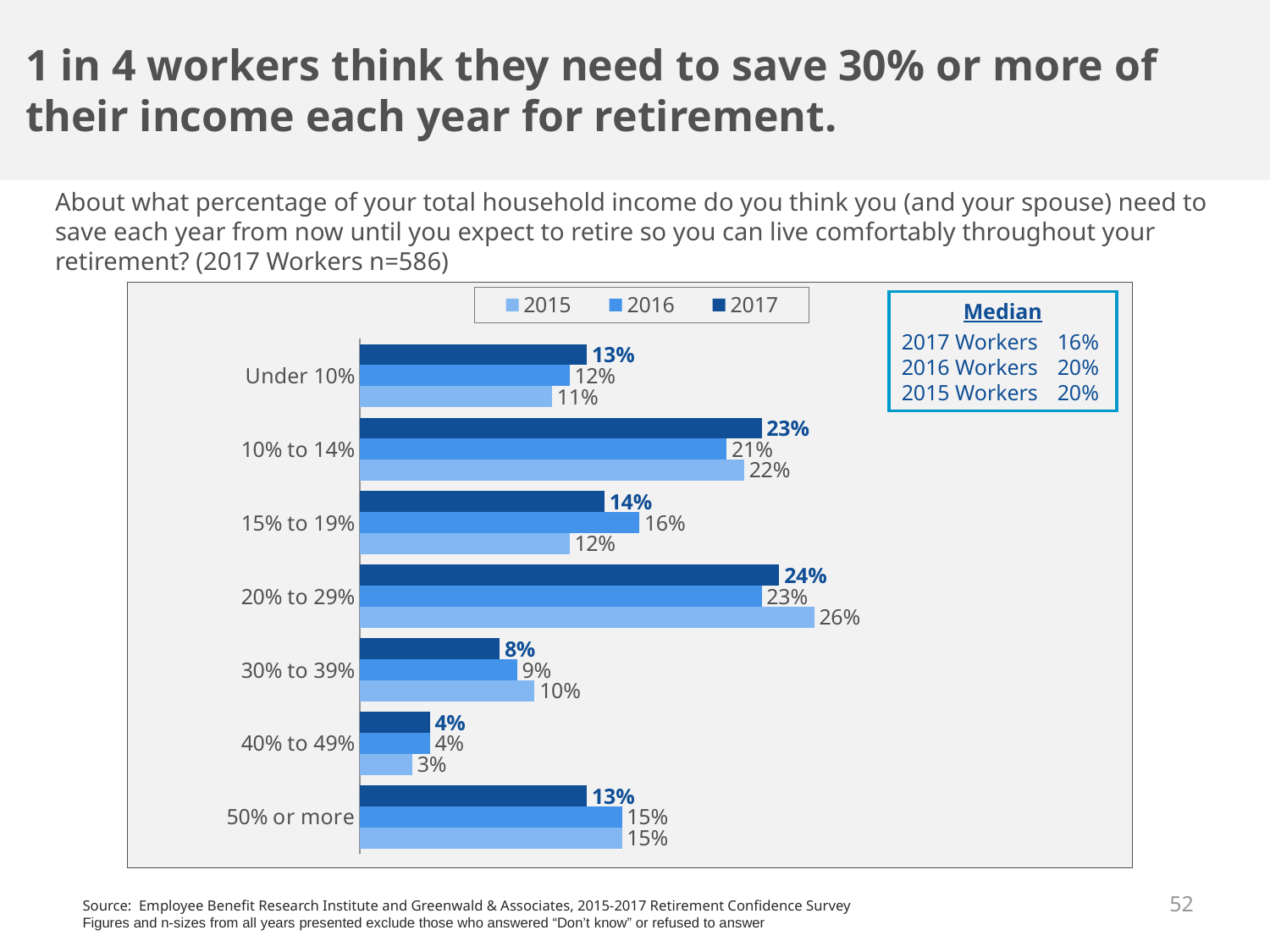
Which series is shown in the darkest blue? 2017 What kind of chart is shown on the slide? Bar chart What is the 2015 value for the "Under 10%" category? 11% What is the 2016 value for the "50% or more" category? 15% How many series does the legend list? 3 Which is larger for the "15% to 19%" category: the 2016 value or the 2017 value? 2016 Which category has the lowest 2015 value? 40% to 49% What is the 2017 value for the "20% to 29%" category? 24% Which category has the highest 2017 value? 20% to 29% What is the difference between the 2015 and 2017 values for the "20% to 29%" category? 2% What is the median for 2017 Workers shown in the box on the chart? 16% How many categories are shown on the chart? 7